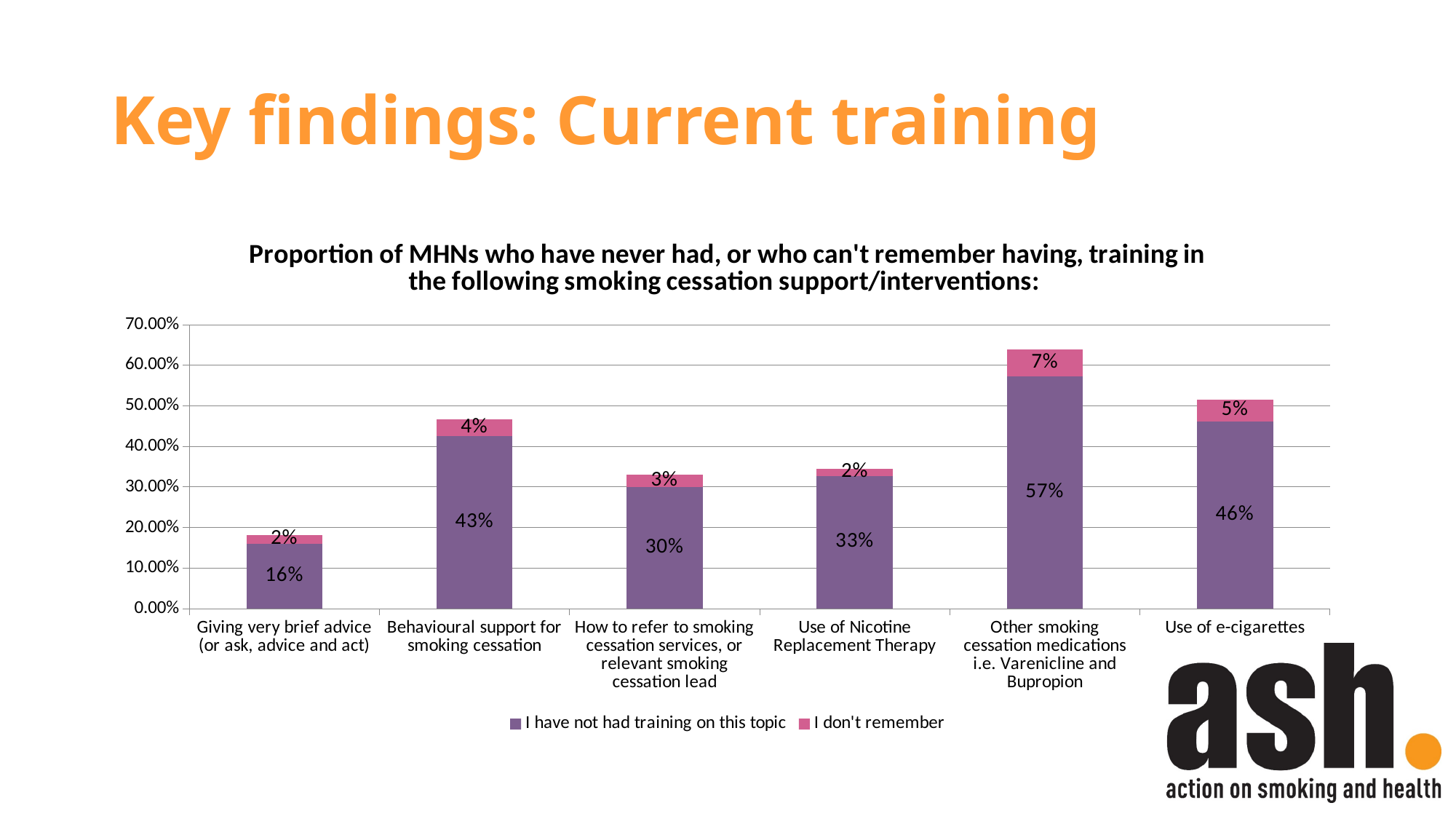
What is the total of the stacked bar for 'Giving very brief advice (or ask, advice and act)'? 18% How many series does the legend list? 2 How many categories are shown on the x axis of the chart? 6 Which category has the lowest 'I have not had training on this topic' value? Giving very brief advice (or ask, advice and act) What percentage of MHNs have not had training on 'Use of e-cigarettes'? 46% What is the 'I don't remember' value for 'Other smoking cessation medications i.e. Varenicline and Bupropion'? 7% Which is larger: the 'I don't remember' value for 'Use of e-cigarettes' or for 'Behavioural support for smoking cessation'? Use of e-cigarettes Which category has the highest 'I have not had training on this topic' value? Other smoking cessation medications i.e. Varenicline and Bupropion What is the 'I have not had training on this topic' value for 'Use of Nicotine Replacement Therapy'? 33% What is the difference between the 'I have not had training on this topic' values for 'Behavioural support for smoking cessation' and 'How to refer to smoking cessation services, or relevant smoking cessation lead'? 13% What is the total of the stacked bar for 'Other smoking cessation medications i.e. Varenicline and Bupropion'? 64% What kind of chart is shown on the slide? Stacked bar chart